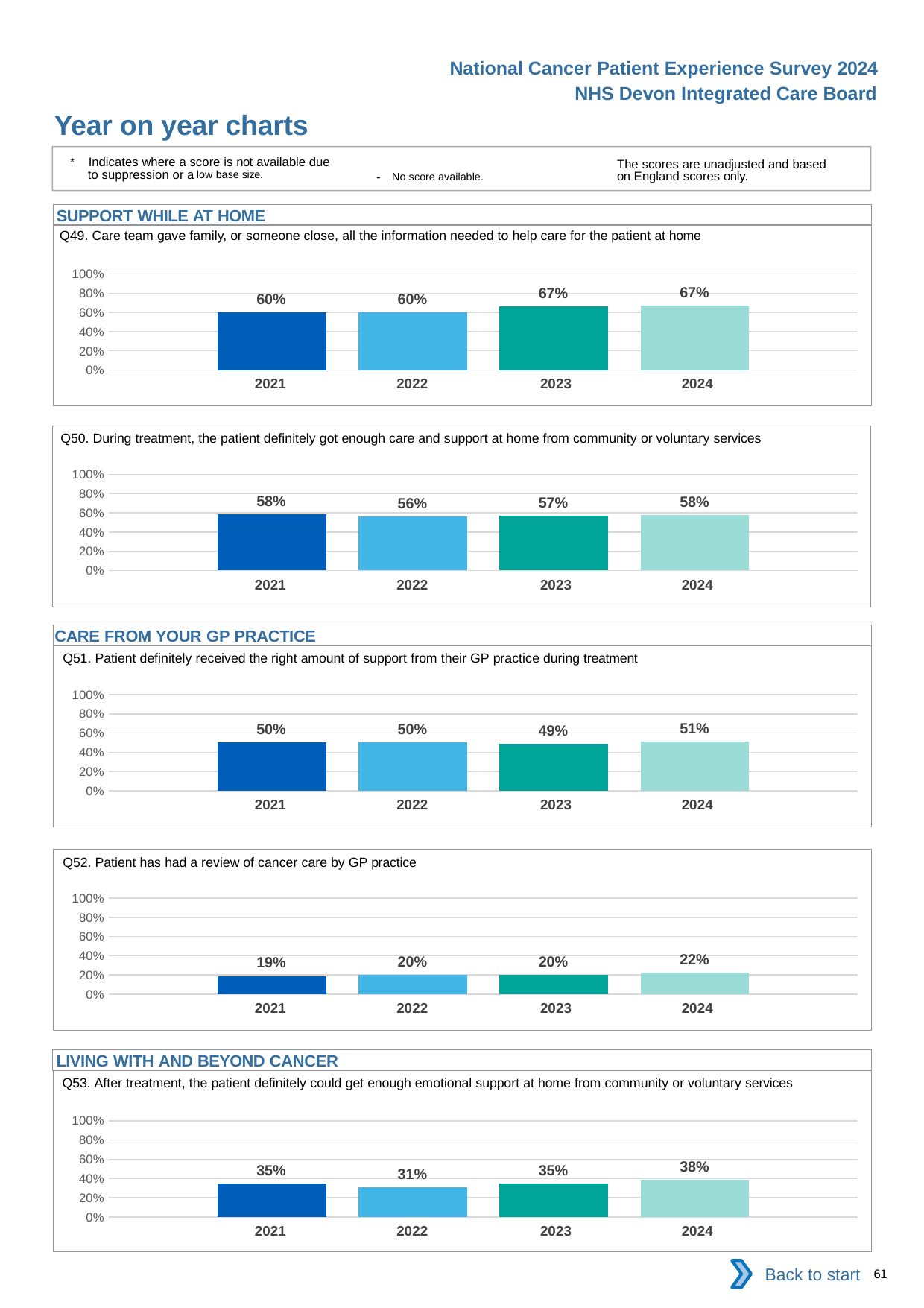
In the Q52 chart, is the value for 2024 greater or less than 40%? less In the Q49 chart, what is the difference between the 2023 value and the 2021 value? 7% In the Q51 chart, which year has the highest value? 2024 In the Q50 chart, which year has the lowest value? 2022 In the Q53 chart, which is larger, the value for 2022 or the value for 2024? 2024 How many years are shown on the x axis of the Q52 chart? 4 In the Q50 chart, what is the value for 2023? 57% What type of chart is the Q49 chart? Bar chart In the Q52 chart, what is the value for 2021? 19% In the Q51 chart, what is the value for 2023? 49% In the Q49 chart, what is the value for 2024? 67% In the Q53 chart, what is the difference between the 2024 value and the 2022 value? 7%